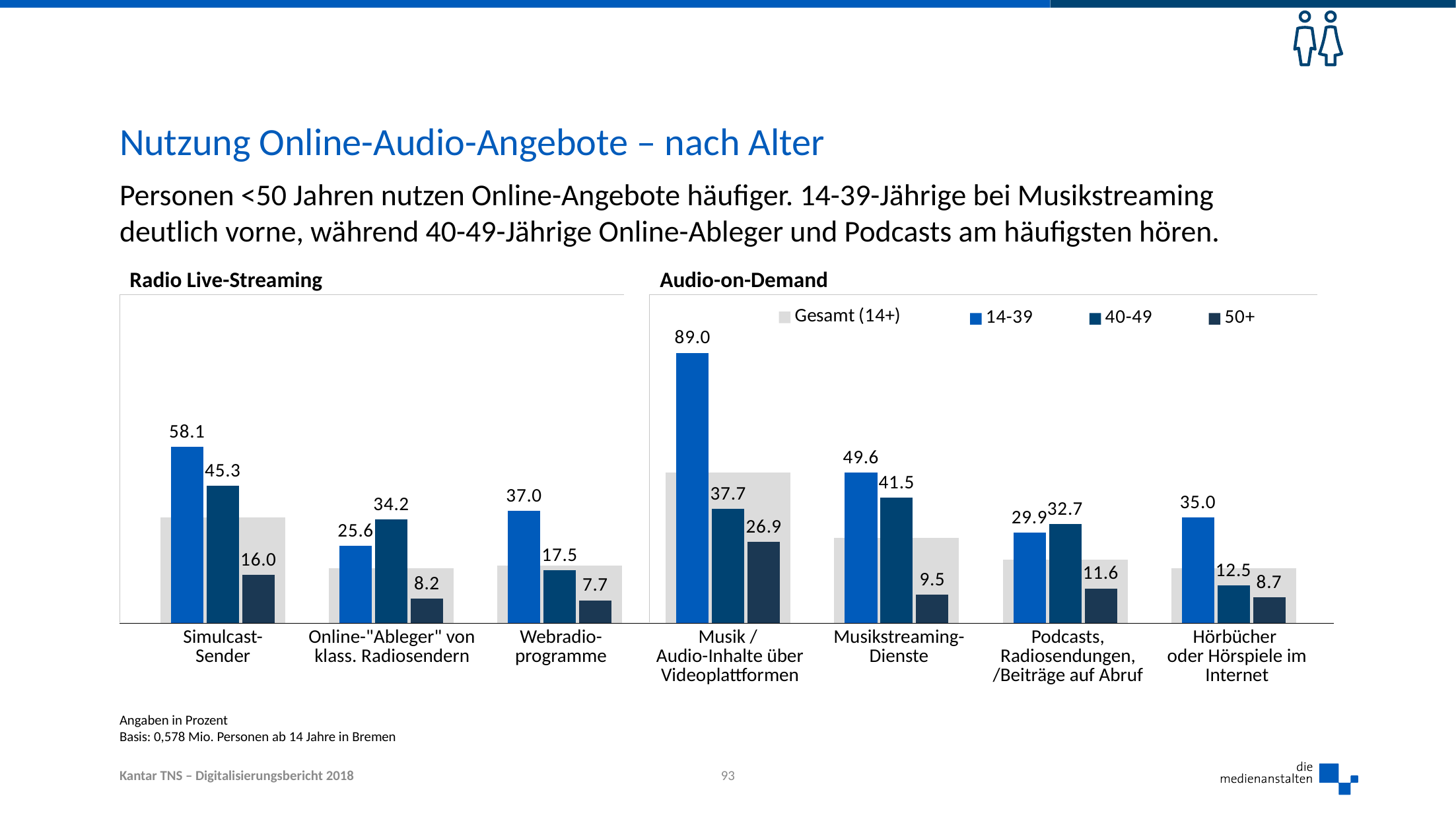
In the Audio-on-Demand chart, what is the difference between the 14-39 and 40-49 values for Musik / Audio-Inhalte über Videoplattformen? 51.3 In the Audio-on-Demand chart, which category has the highest value for the 14-39 age group? Musik / Audio-Inhalte über Videoplattformen Which series in the legend is shown in light grey? Gesamt (14+) How many series does the legend list? 4 In the Radio Live-Streaming chart, which is larger for Online-"Ableger" von klass. Radiosendern: the 14-39 value or the 40-49 value? 40-49 How many categories are shown in the Audio-on-Demand chart? 4 In the Radio Live-Streaming chart, what is the value for the 14-39 age group for Simulcast-Sender? 58.1 In the Audio-on-Demand chart, what is the value for the 50+ age group for Musikstreaming-Dienste? 9.5 In the Audio-on-Demand chart, what is the value for the 40-49 age group for Podcasts, Radiosendungen, /Beiträge auf Abruf? 32.7 In the Radio Live-Streaming chart, what is the difference between the 14-39 and 50+ values for Simulcast-Sender? 42.1 What kind of chart is the Radio Live-Streaming chart? bar chart In the Radio Live-Streaming chart, which category has the lowest value for the 50+ age group? Webradio-programme